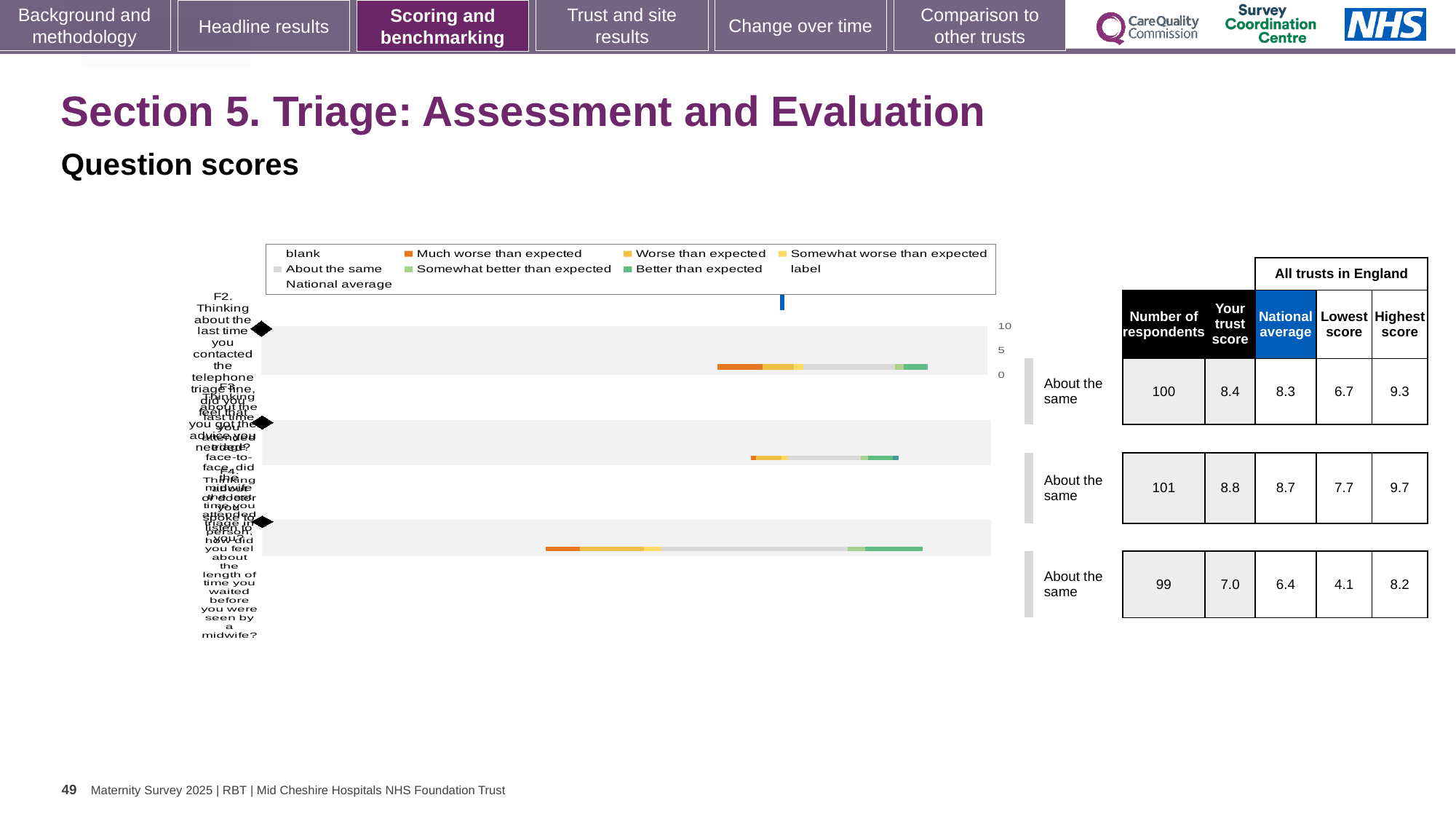
What kind of chart is shown on the slide? bar chart What is the number of respondents for the third (bottom) question row? 99 For the first question row, F2, which is larger: the trust score or the national average? the trust score (8.4) What colour does the legend use for 'Much worse than expected'? orange What is the highest score across all trusts in England for the first question row, F2? 9.3 Which question row has the lowest 'Lowest score' across all trusts in England? the third row (4.1) What is the national average for the second question row? 8.7 For the third question row, what is the difference between the trust score and the national average? 0.6 How many question rows are plotted in the chart? 3 Which question row has the highest 'Your trust score'? the second row (8.8) What is the 'Your trust score' for the first (top) question row, F2? 8.4 What benchmark category is shown for each of the three question rows? About the same